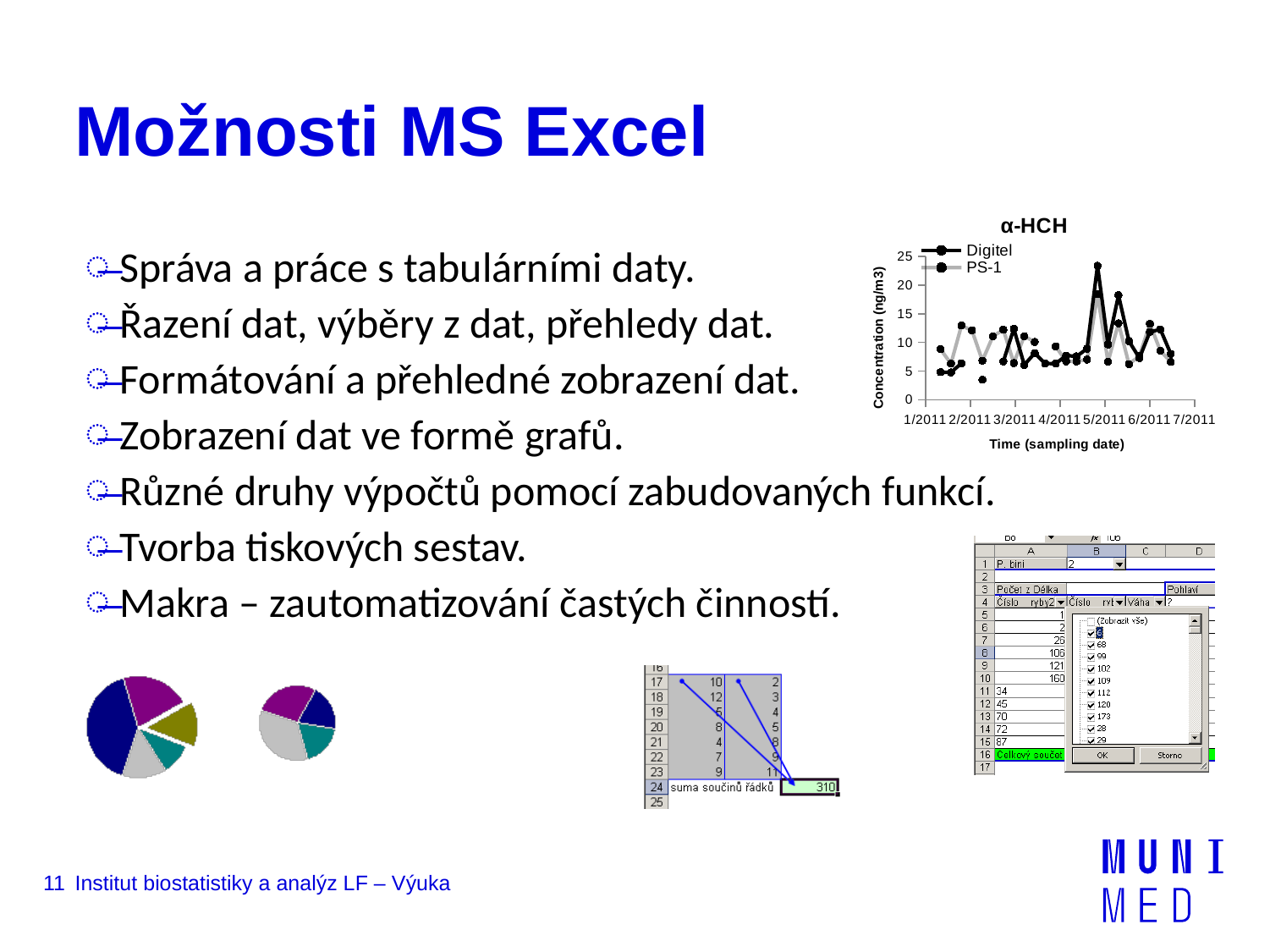
What kind of charts are the two small charts in the lower left of the slide? pie charts In the α-HCH chart, are the values of the Digitel series at the start of the x axis (1/2011) greater or less than 10? less How many series does the legend of the α-HCH chart list? 2 What are the names of the two series in the α-HCH chart's legend? Digitel and PS-1 What kind of chart is the α-HCH chart in the upper right of the slide? line chart In the α-HCH chart, which series reaches the higher peak around 5/2011, Digitel or PS-1? Digitel In the α-HCH chart, is the highest peak of the PS-1 series (around 5/2011) greater or less than 15? greater In the α-HCH chart, is the highest peak of the Digitel series (around 5/2011) greater or less than 20? greater What is the highest tick value shown on the y axis of the α-HCH chart? 25 What is the title of the line chart on the slide? α-HCH How many date labels are shown on the x axis of the α-HCH chart? 7